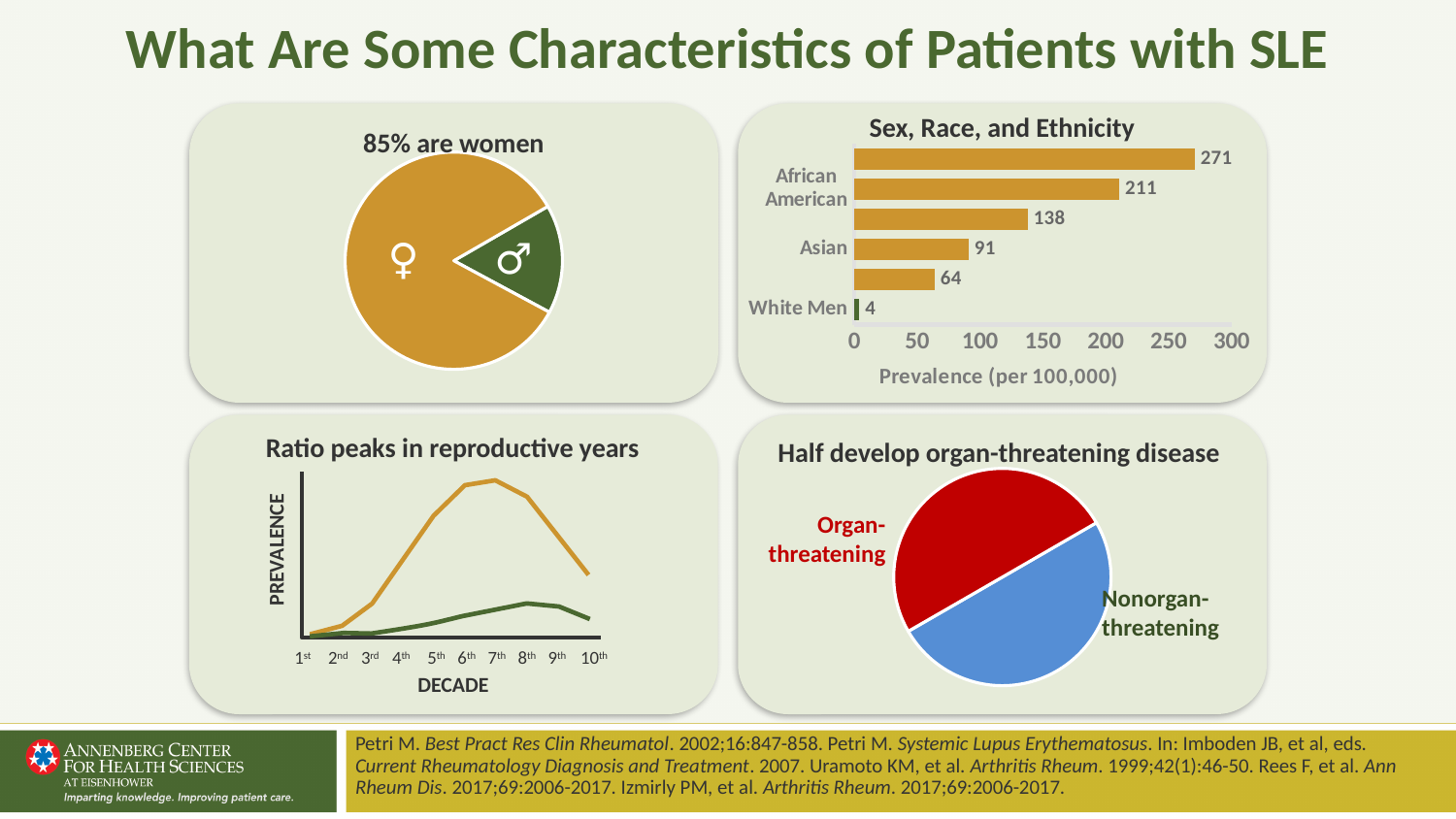
In the 'Sex, Race, and Ethnicity' chart, what is the highest prevalence value shown? 271 In the 'Sex, Race, and Ethnicity' chart, what is the prevalence value for White Men? 4 In the 'Sex, Race, and Ethnicity' chart, what is the prevalence value for Asian? 91 In the 'Sex, Race, and Ethnicity' chart, what is the difference between the highest bar (271) and the second highest bar (211)? 60 In the '85% are women' pie chart, what share of patients are women? 85% In the 'Sex, Race, and Ethnicity' chart, what is the x-axis title? Prevalence (per 100,000) In the 'Ratio peaks in reproductive years' chart, how many decades are shown on the x axis? 10 In the 'Ratio peaks in reproductive years' chart, does the orange line rise or fall from the 7th decade to the 10th decade? fall What kind of chart is the 'Sex, Race, and Ethnicity' chart? Bar chart In the 'Sex, Race, and Ethnicity' chart, how many bars are plotted? 6 In the 'Sex, Race, and Ethnicity' chart, is the bar labeled 138 greater or less than 150? less In the 'Half develop organ-threatening disease' pie chart, how many slices are there? 2